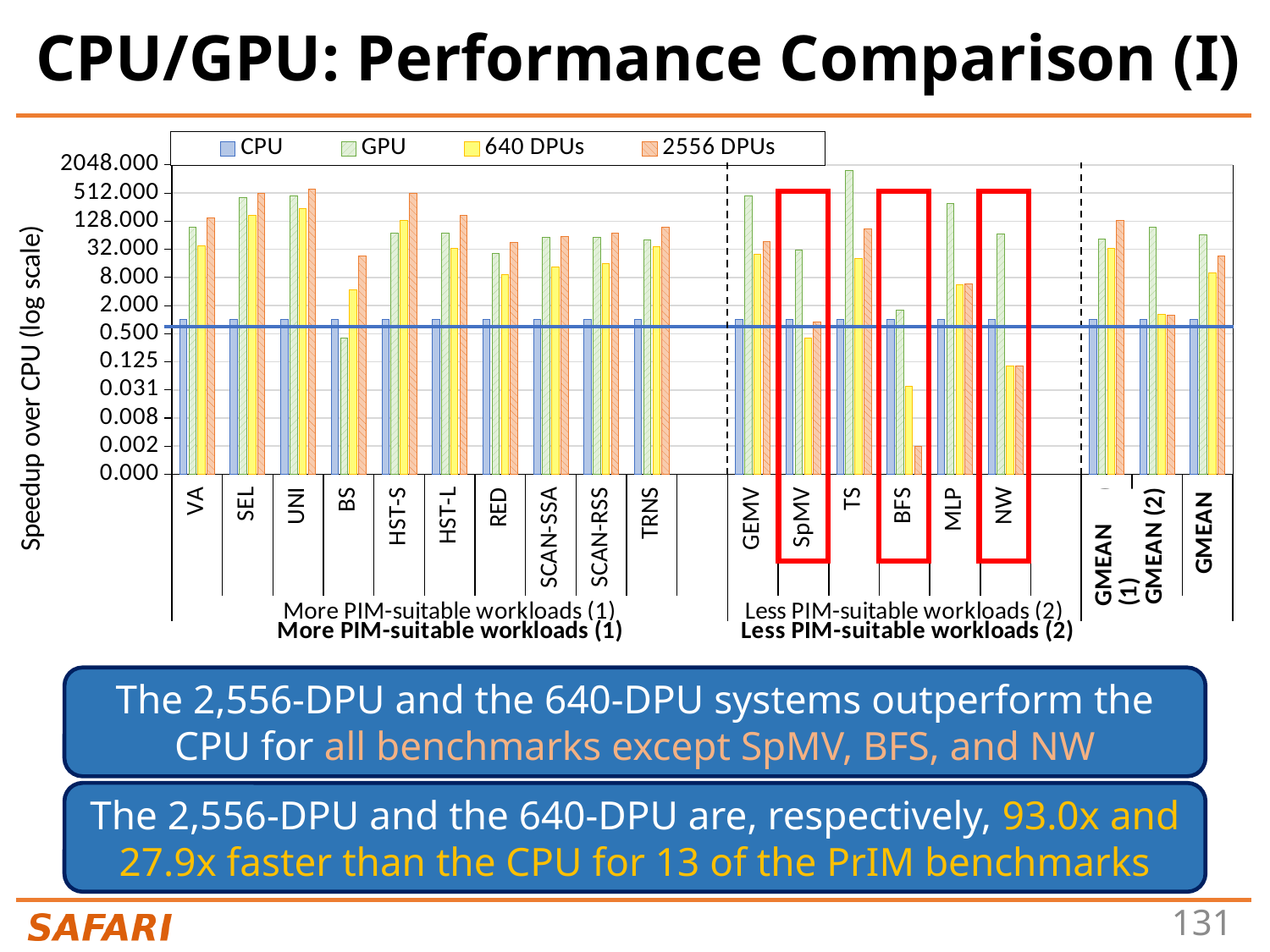
Is the GPU value for GEMV greater or less than 128.000? greater How many series does the chart legend list? 4 How many benchmark categories (including the GMEAN entries) are shown along the x axis? 19 For TS, which series has the highest bar? GPU Is the GPU value for TS greater or less than 512.000? greater What kind of chart is shown on the slide? bar chart For BS, which is larger: the GPU value or the 2556 DPUs value? 2556 DPUs Across all categories, which one has the lowest 2556 DPUs bar? BFS What is the label of the y axis? Speedup over CPU (log scale) Is the 2556 DPUs value for BFS greater or less than 0.008? less